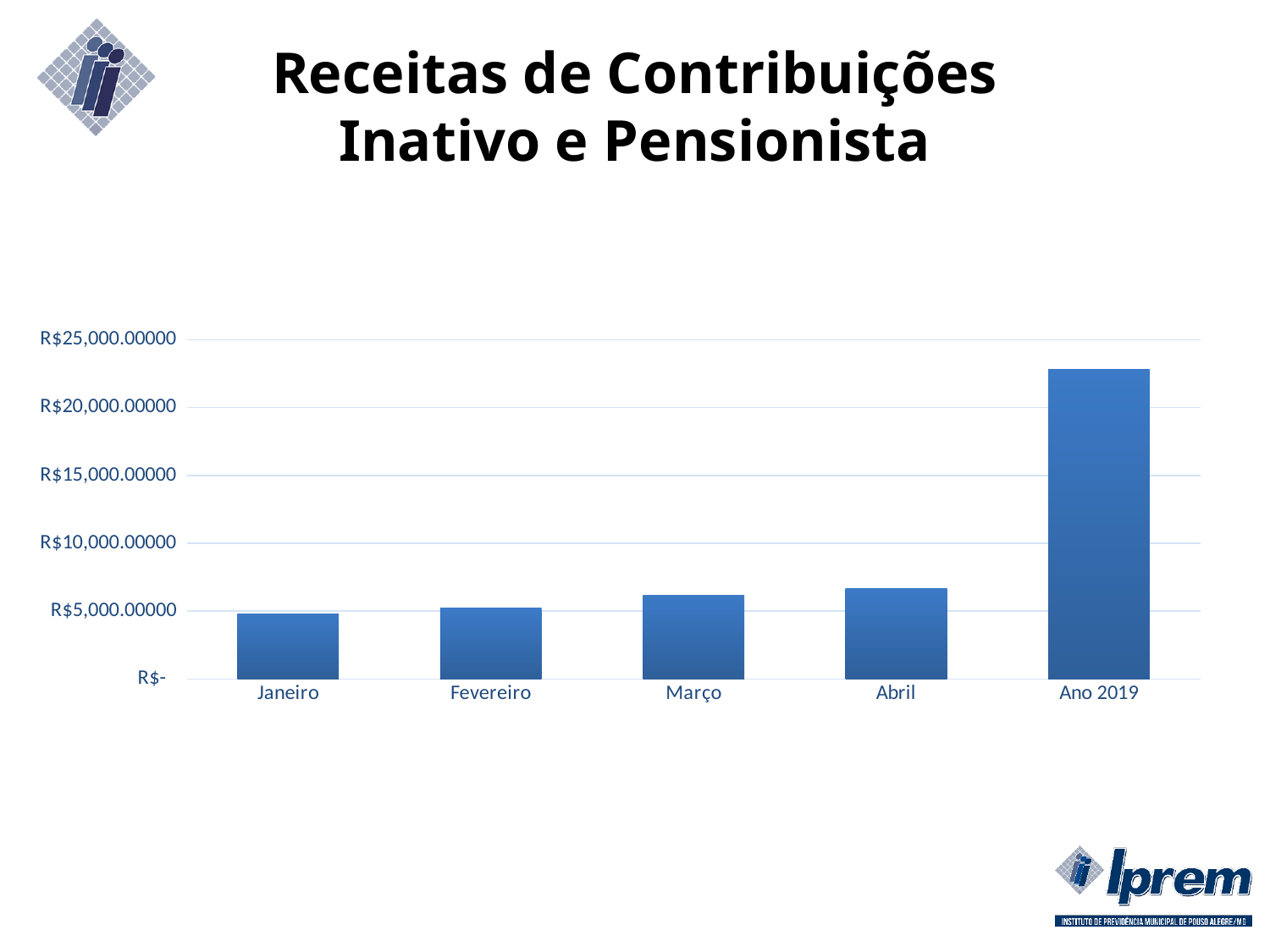
Is the value for Março greater or less than R$5,000.00000? greater Is the value for Ano 2019 greater or less than R$25,000.00000? less Which category has the lowest value in the chart? Janeiro What kind of chart is shown on the slide? bar chart How many categories are shown on the x axis of the chart? 5 Is the value for Ano 2019 greater or less than R$20,000.00000? greater Which is larger, the value for Abril or the value for Janeiro? Abril What is the title of the slide containing the chart? Receitas de Contribuições Inativo e Pensionista Which is larger, the value for Março or the value for Fevereiro? Março Do the values rise or fall from Janeiro to Abril? rise Which category has the highest value in the chart? Ano 2019